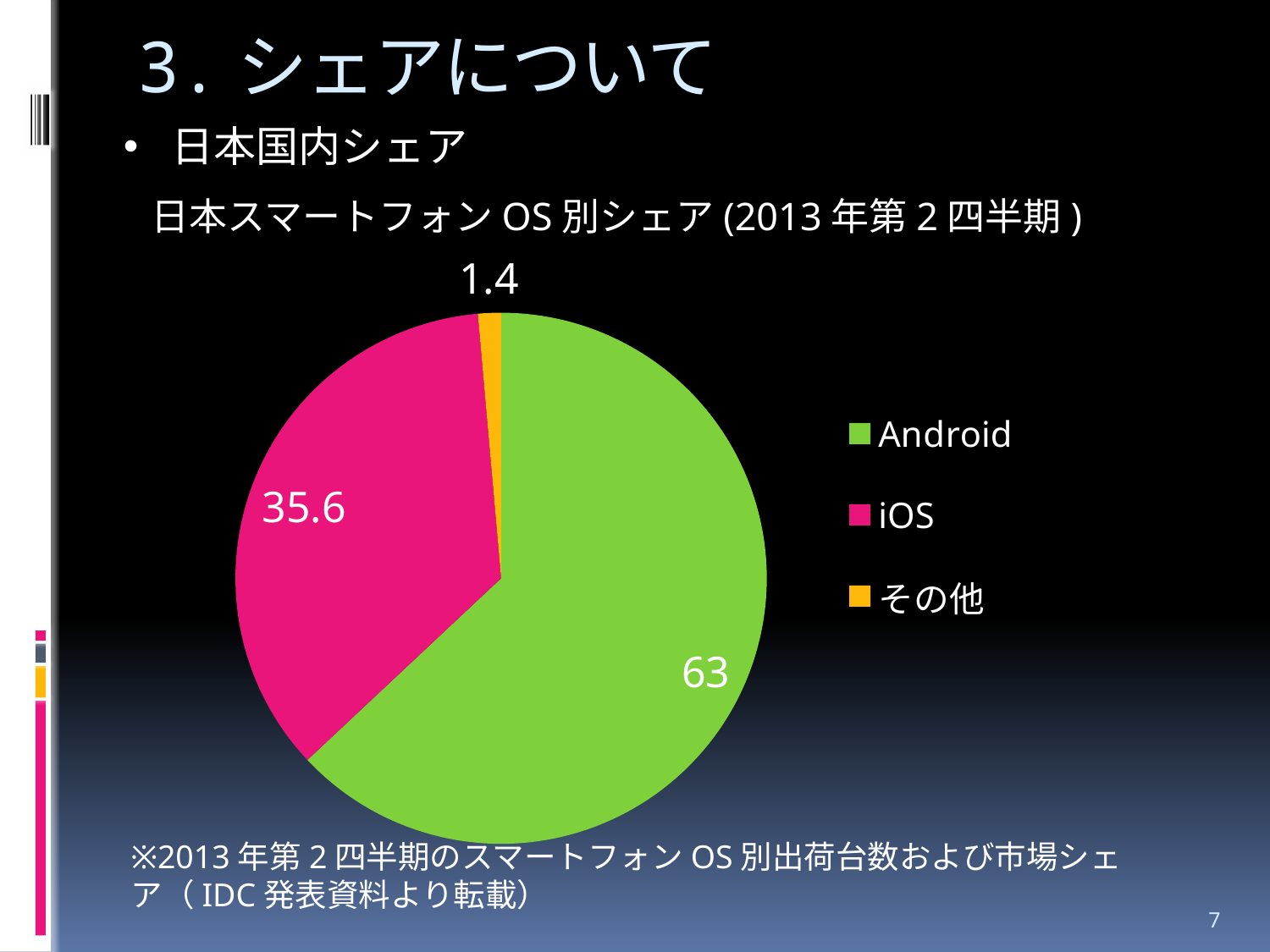
What is the value for iOS in the pie chart? 35.6 What is the value for その他 in the pie chart? 1.4 What is the difference between the values for Android and iOS? 27.4 Which category has the largest share of the pie? Android What is the title of the chart? 日本スマートフォン OS 別シェア (2013 年第 2 四半期 ) What is the value for Android in the pie chart? 63 How many slices does the pie chart have? 3 Which category has the smallest share of the pie? その他 What colour is the iOS slice in the pie chart? pink What type of chart is shown on the slide? pie chart How many entries does the legend list? 3 Which is larger, the value for iOS or the value for その他? iOS